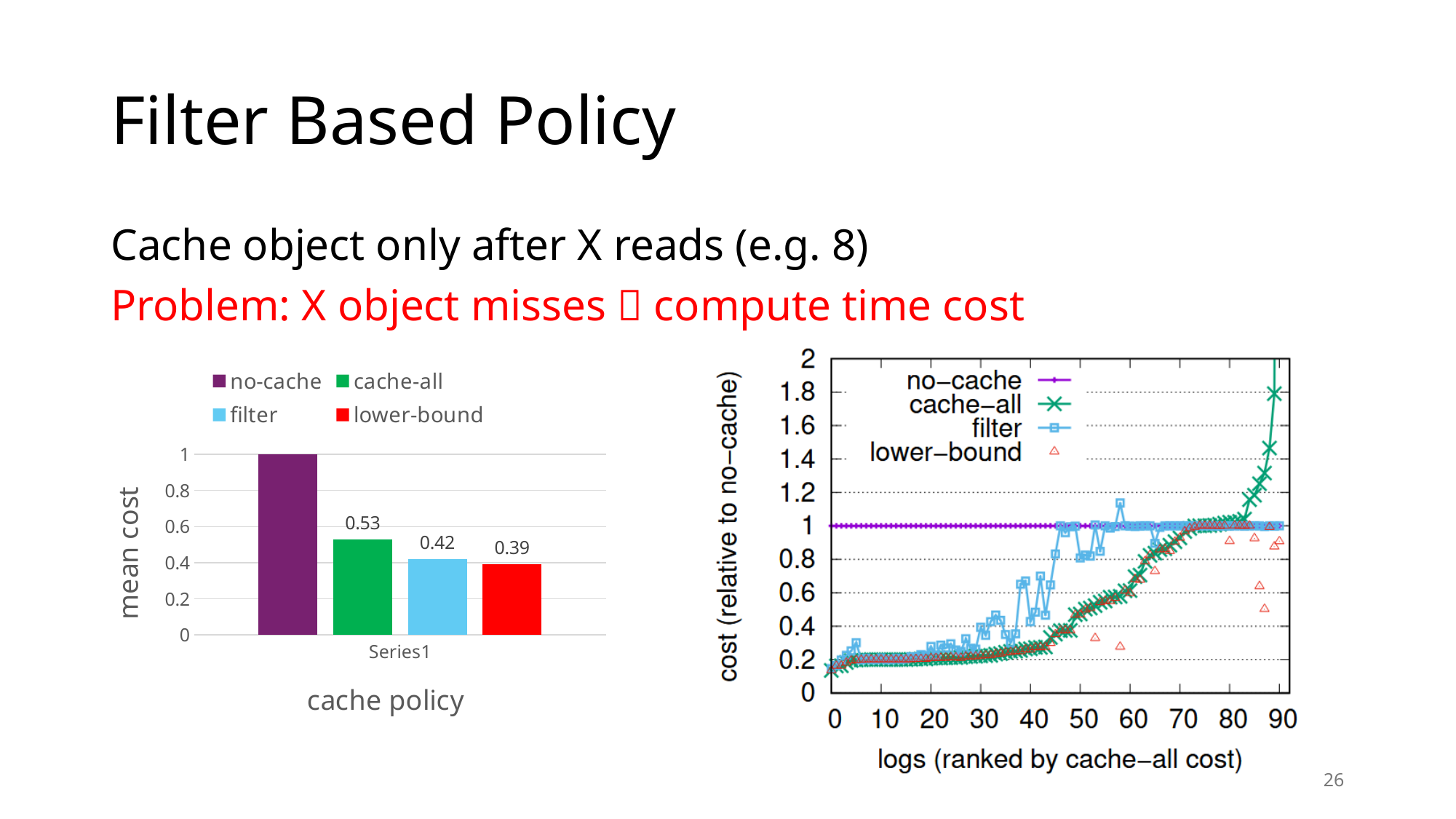
In the chart on the right, does the cache-all cost rise or fall as the log rank increases along the x axis? rise In the bar chart on the left, what is the mean cost for lower-bound? 0.39 How many series does the legend of the bar chart on the left list? 4 In the bar chart on the left, is the mean cost for no-cache greater or less than 0.8? greater In the bar chart on the left, what is the mean cost for cache-all? 0.53 In the bar chart on the left, what is the difference in mean cost between cache-all and filter? 0.11 What kind of chart is the chart on the left of the slide? bar chart In the bar chart on the left, what is the mean cost for filter? 0.42 In the bar chart on the left, which cache policy has the lowest mean cost? lower-bound In the bar chart on the left, which has a larger mean cost, filter or lower-bound? filter In the bar chart on the left, which cache policy has the highest mean cost? no-cache In the chart on the right, what is the label of the x axis? logs (ranked by cache-all cost)